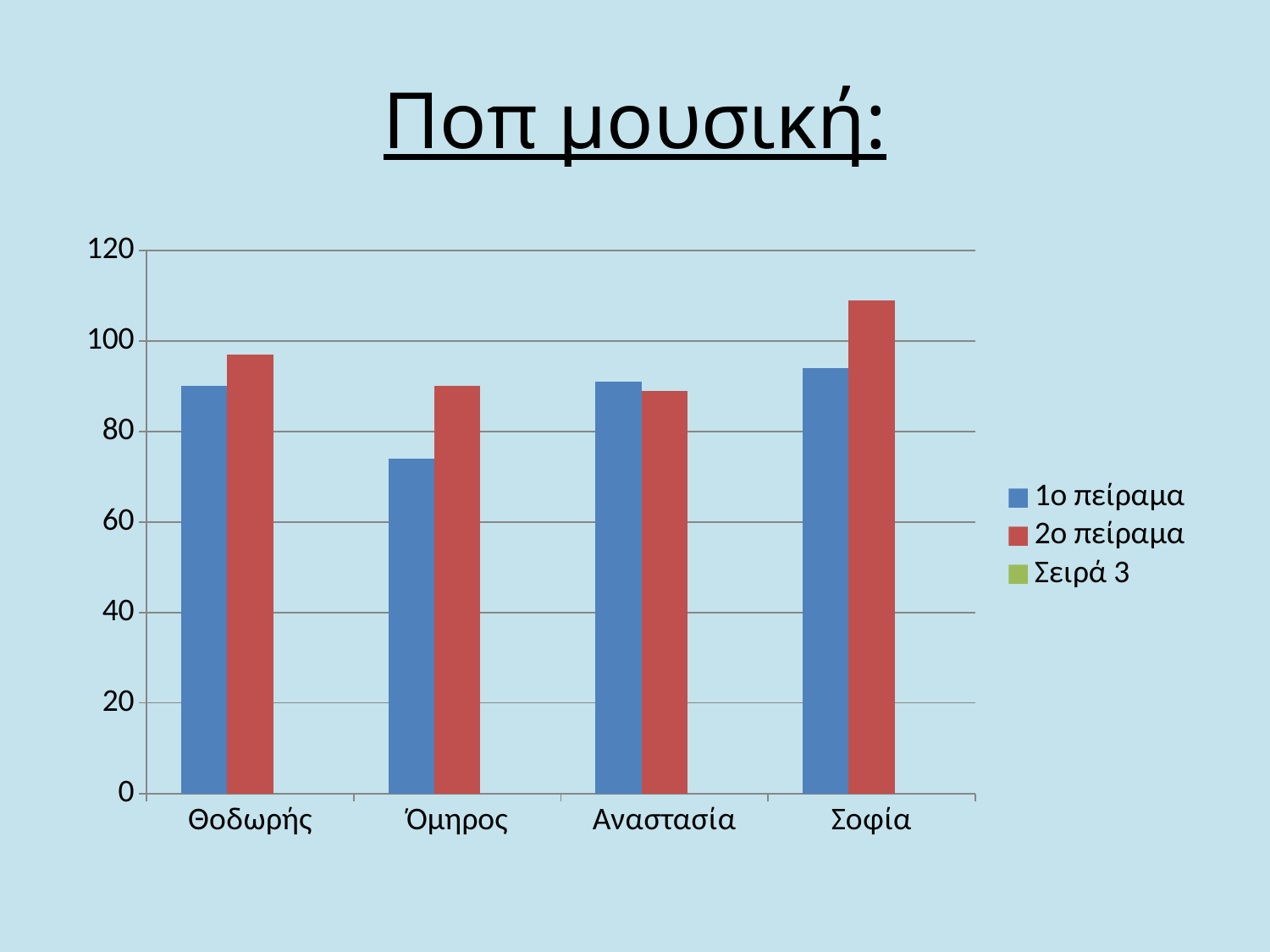
Is the value for Αναστασία in 1ο πείραμα greater or less than 80? greater Is the value for Σοφία in 2ο πείραμα greater or less than 100? greater What is the title of the slide? Ποπ μουσική: How many categories (people) are shown on the x axis? 4 What kind of chart is shown on the slide? bar chart Which category has the highest value for 2ο πείραμα? Σοφία For Όμηρος, which is larger: 1ο πείραμα or 2ο πείραμα? 2ο πείραμα How many series does the legend list? 3 For Θοδωρής, which is larger: 1ο πείραμα or 2ο πείραμα? 2ο πείραμα Which category has the lowest value for 1ο πείραμα? Όμηρος For Σοφία, which is larger: 1ο πείραμα or 2ο πείραμα? 2ο πείραμα Is the value for Όμηρος in 1ο πείραμα greater or less than 80? less